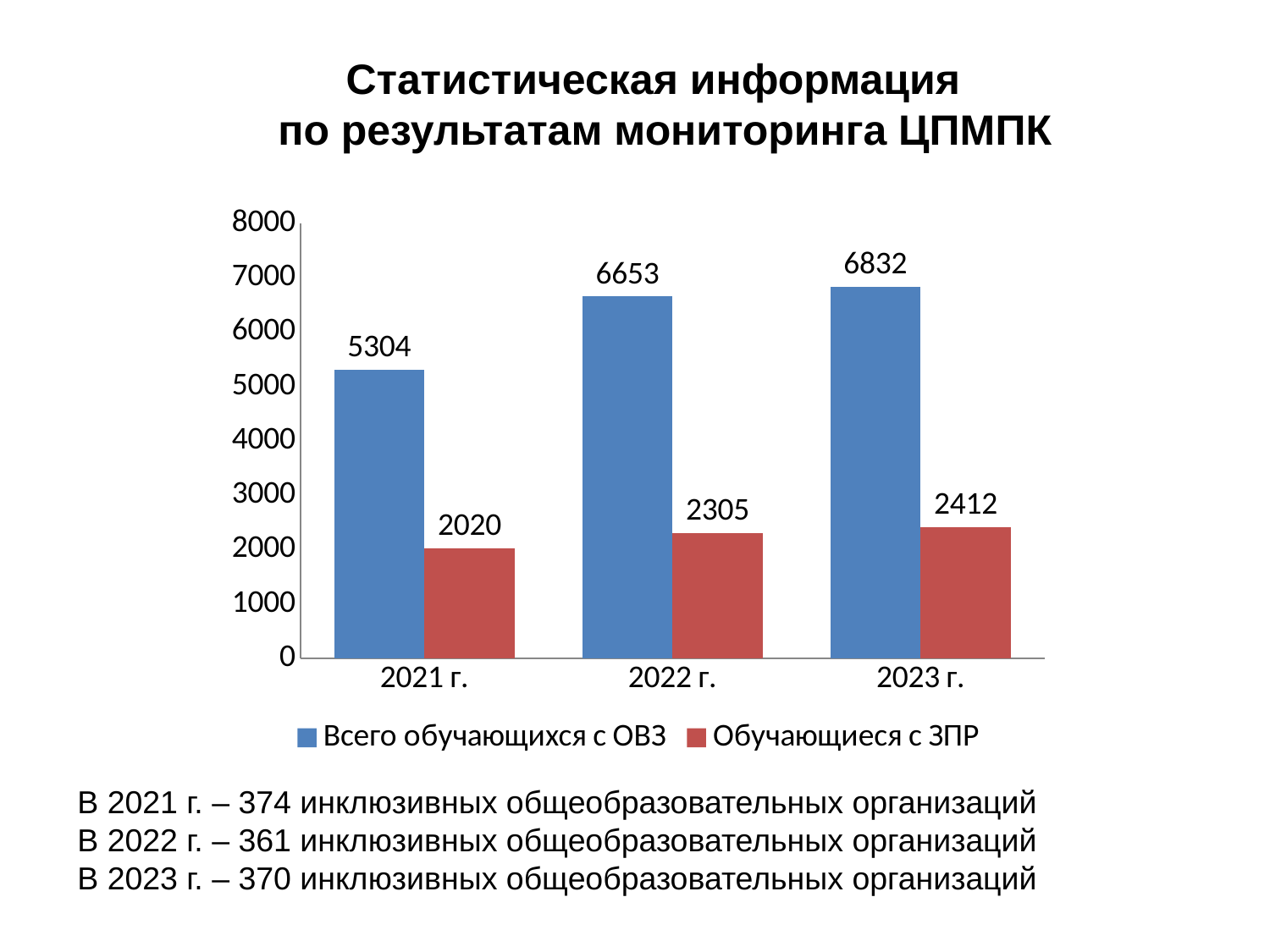
In which year is 'Всего обучающихся с ОВЗ' highest? 2023 г. What is the value for 'Обучающиеся с ЗПР' in 2023 г.? 2412 What kind of chart is shown on the slide? bar chart How many series does the legend list? 2 By how much did 'Всего обучающихся с ОВЗ' increase from 2021 г. to 2023 г.? 1528 Which is larger: 'Обучающиеся с ЗПР' in 2021 г. or in 2023 г.? 2023 г. What is the difference between 'Всего обучающихся с ОВЗ' and 'Обучающиеся с ЗПР' in 2022 г.? 4348 In which year is 'Обучающиеся с ЗПР' lowest? 2021 г. How many years are shown on the x axis? 3 Does 'Всего обучающихся с ОВЗ' rise or fall from 2021 г. to 2023 г.? rise What is the value for 'Обучающиеся с ЗПР' in 2022 г.? 2305 What is the value for 'Всего обучающихся с ОВЗ' in 2021 г.? 5304